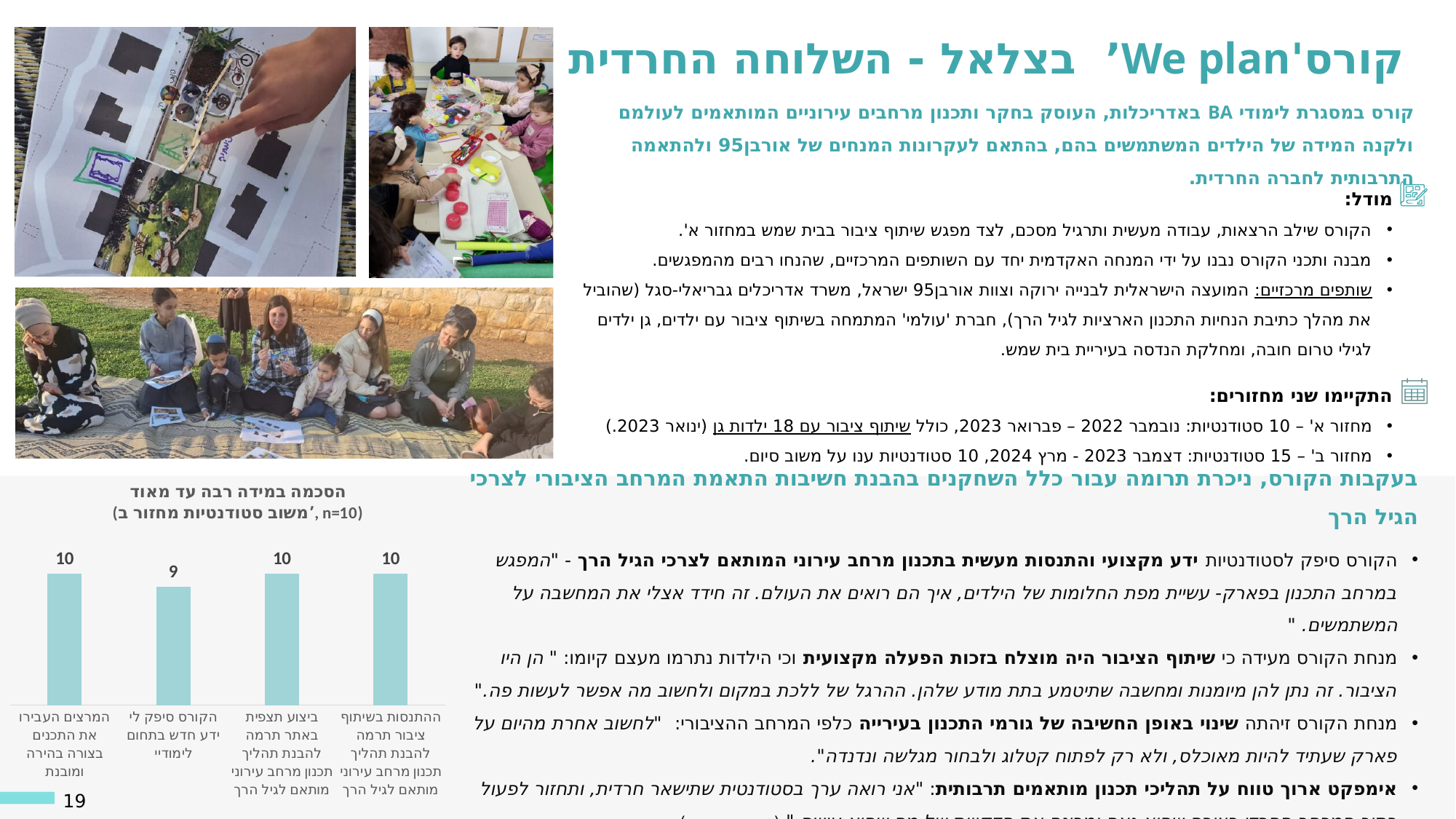
What is the sample size (n) stated in the chart's title? n=10 What is the value for the category 'הקורס סיפק לי ידע חדש בתחום לימודיי'? 9 Which is larger: the value for 'ביצוע תצפית באתר תרמה להבנת תהליך תכנון מרחב עירוני מותאם לגיל הרך' or the value for 'הקורס סיפק לי ידע חדש בתחום לימודיי'? ביצוע תצפית באתר תרמה להבנת תהליך תכנון מרחב עירוני מותאם לגיל הרך What type of chart is shown at the bottom left of the slide? bar chart How many categories (bars) does the chart show? 4 What is the title of the chart? הסכמה במידה רבה עד מאוד (משוב סטודנטיות מחזור ב', n=10) What is the value for the category 'המרצים העבירו את התכנים בצורה בהירה ומובנת'? 10 What is the value for the category 'ההתנסות בשיתוף ציבור תרמה להבנת תהליך תכנון מרחב עירוני מותאם לגיל הרך'? 10 How many categories in the chart have a value of 10? 3 What is the value for the category 'ביצוע תצפית באתר תרמה להבנת תהליך תכנון מרחב עירוני מותאם לגיל הרך'? 10 Which category has the lowest value in the chart? הקורס סיפק לי ידע חדש בתחום לימודיי What is the difference between the value for 'המרצים העבירו את התכנים בצורה בהירה ומובנת' and the value for 'הקורס סיפק לי ידע חדש בתחום לימודיי'? 1